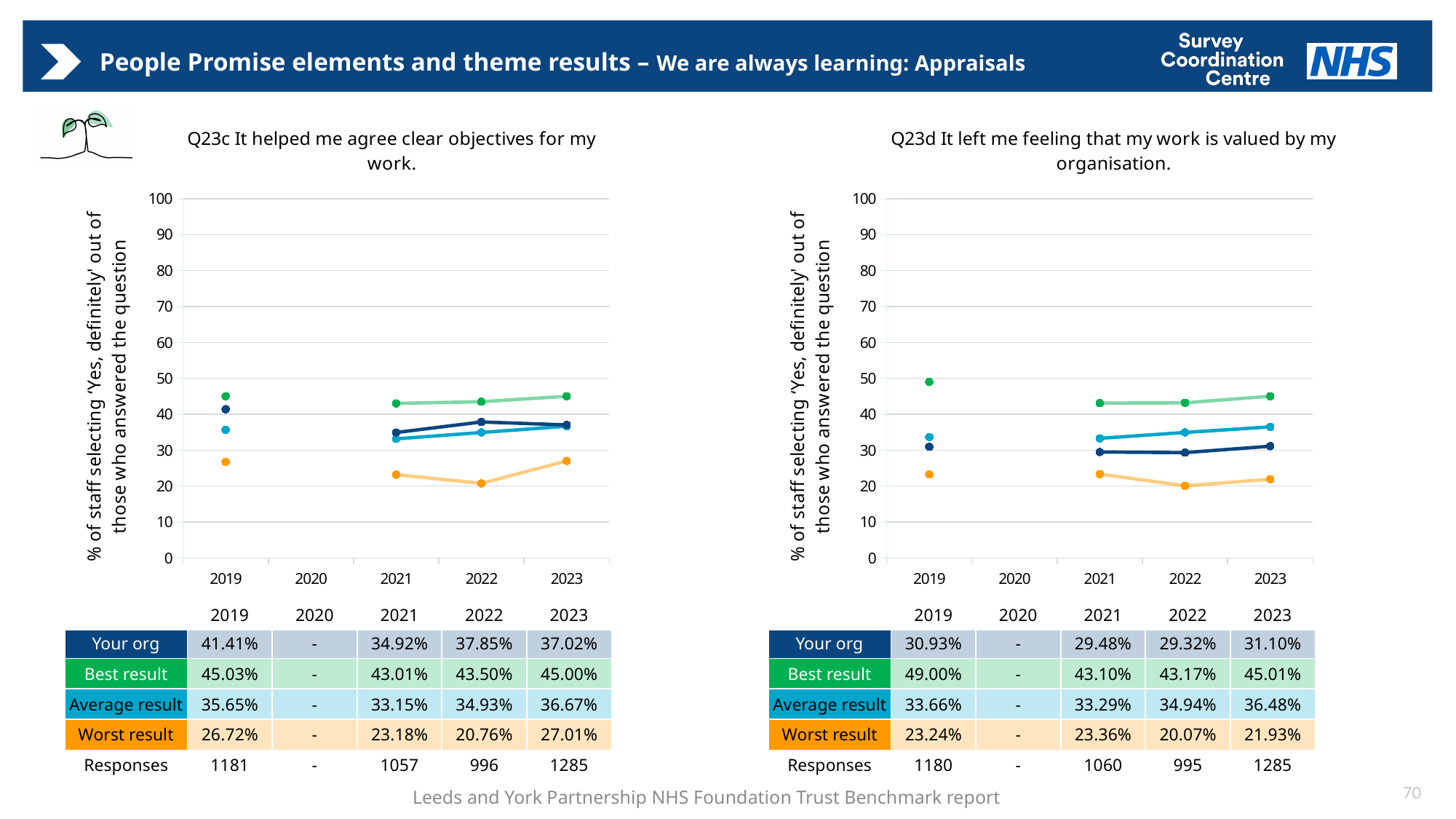
In the Q23d chart (right), which is larger in 2023: Your org or Average result? Average result In the Q23d chart (right), does the Average result rise or fall from 2021 to 2023? Rises What type of chart is the Q23d chart (right)? Line chart In the Q23c chart (left), in which year is the Your org value highest? 2019 In the Q23c chart (left), what is the Your org value for 2022? 37.85% In the Q23c chart (left), what is the difference between the Best result and Your org values in 2023? 7.98 percentage points In the Q23d chart (right), in which year is the Worst result value lowest? 2022 In the Q23d chart (right), how many years have plotted values? 4 In the Q23d chart (right), what is the Best result value for 2019? 49.00% In the Q23c chart (left), how many result series are listed in the table below the chart? 4 In the Q23c chart (left), is the Best result value for 2021 greater or less than 40? greater In the Q23d chart (right), how many responses were there in 2023? 1285